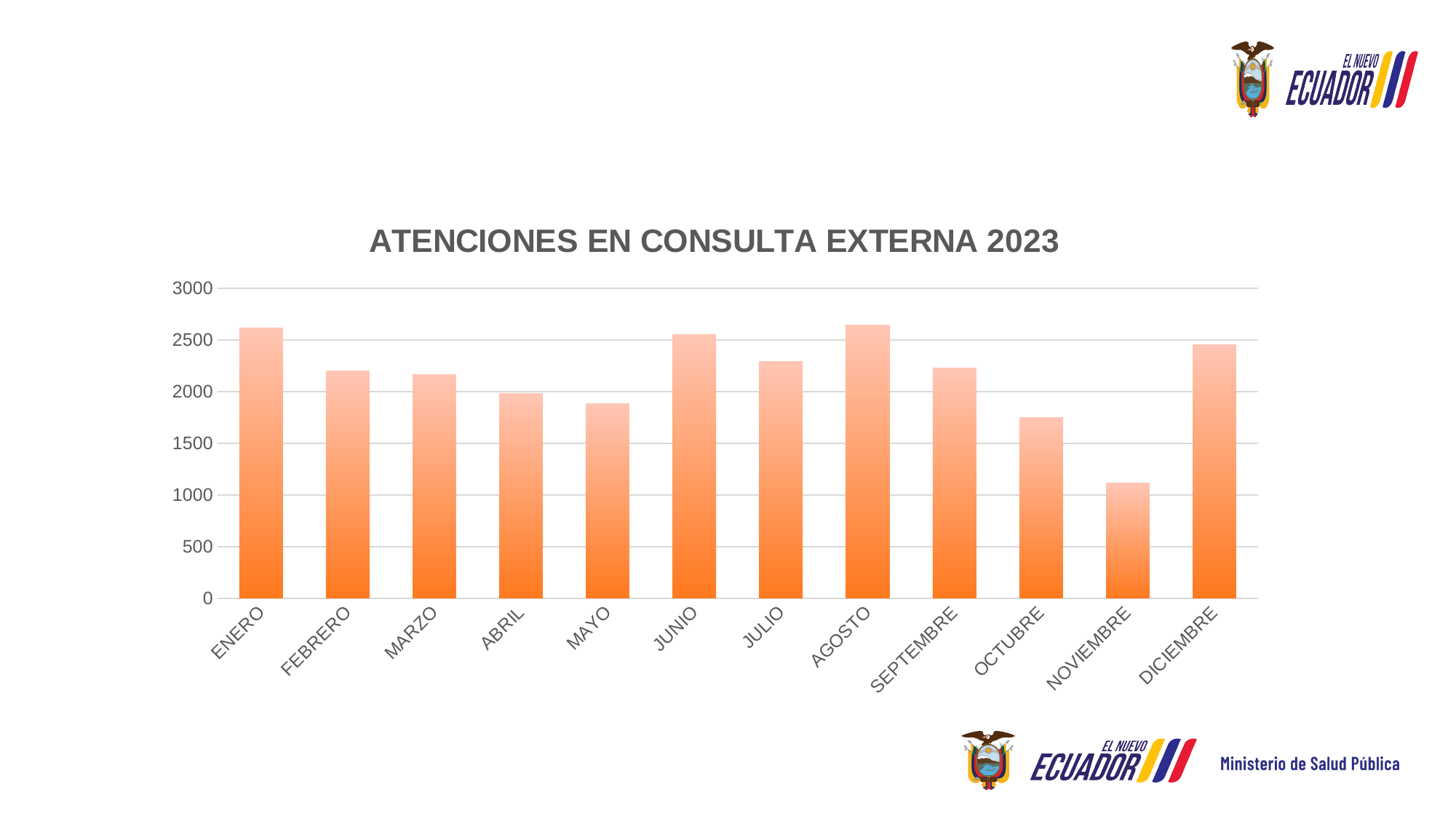
Do the values rise or fall from AGOSTO to NOVIEMBRE? fall Which is larger, the value for FEBRERO or the value for MAYO? FEBRERO Is the value for MAYO greater or less than 2000? less What is the title of the chart? ATENCIONES EN CONSULTA EXTERNA 2023 Which is larger, the value for JUNIO or the value for JULIO? JUNIO Is the value for ENERO greater or less than 2500? greater Is the value for OCTUBRE greater or less than 2000? less How many months (categories) are shown on the x axis? 12 Which month has the lowest value? NOVIEMBRE What kind of chart is shown on the slide? bar chart